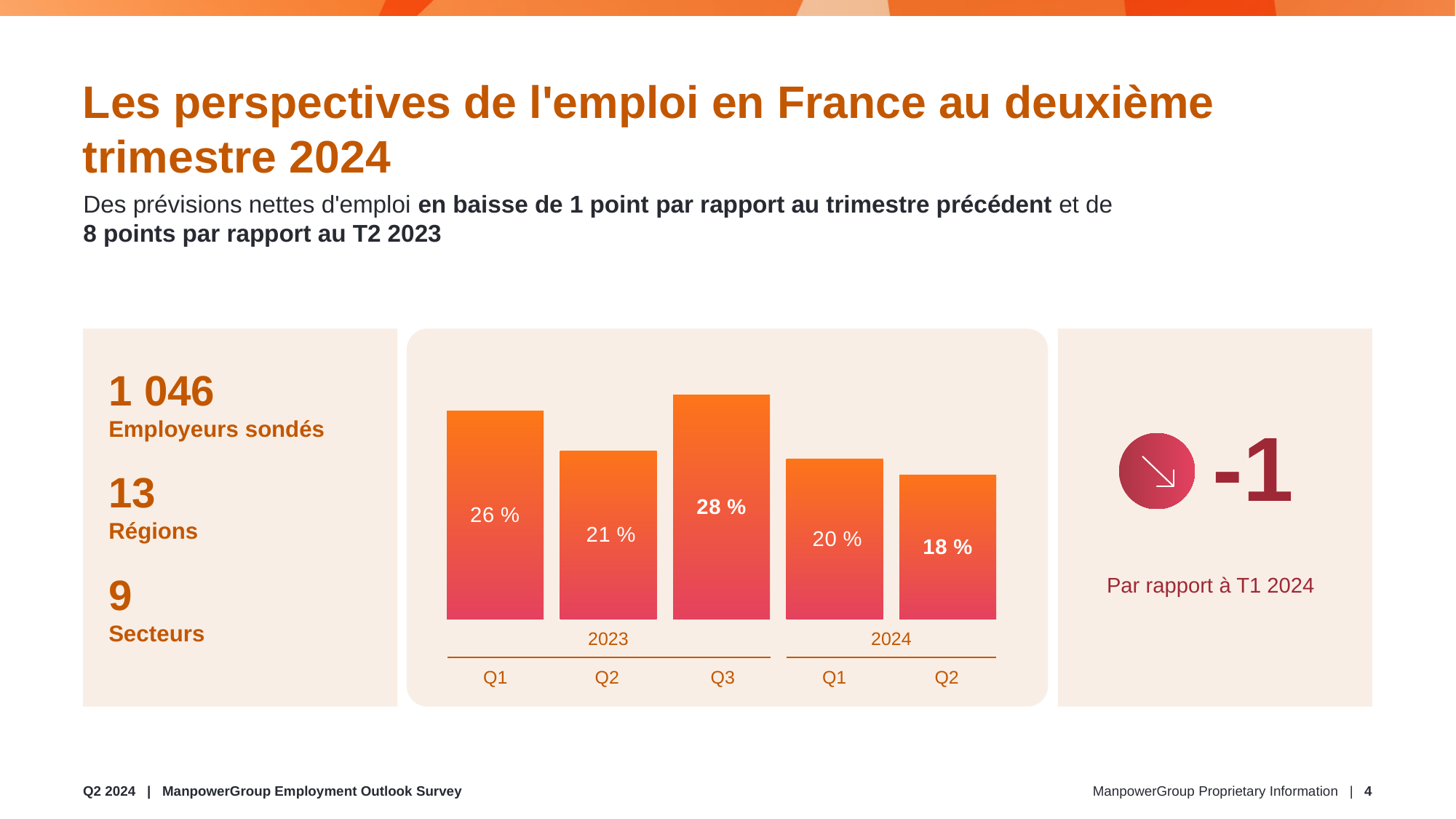
What is the difference between Q1 2024 and Q2 2024? 2 points What is the value for Q3 2023? 28 % Which quarter has the lowest value? Q2 2024 Which is larger, the value for Q2 2023 or Q1 2024? Q2 2023 How many bars are shown in the chart? 5 Which quarter has the highest value? Q3 2023 What is the value for Q1 2023? 26 % What is the value for Q1 2024? 20 % What kind of chart is shown on the slide? Bar chart Do the values rise or fall from Q3 2023 to Q2 2024? Fall What is the difference between Q3 2023 and Q2 2024? 10 points What is the value for Q2 2024? 18 %